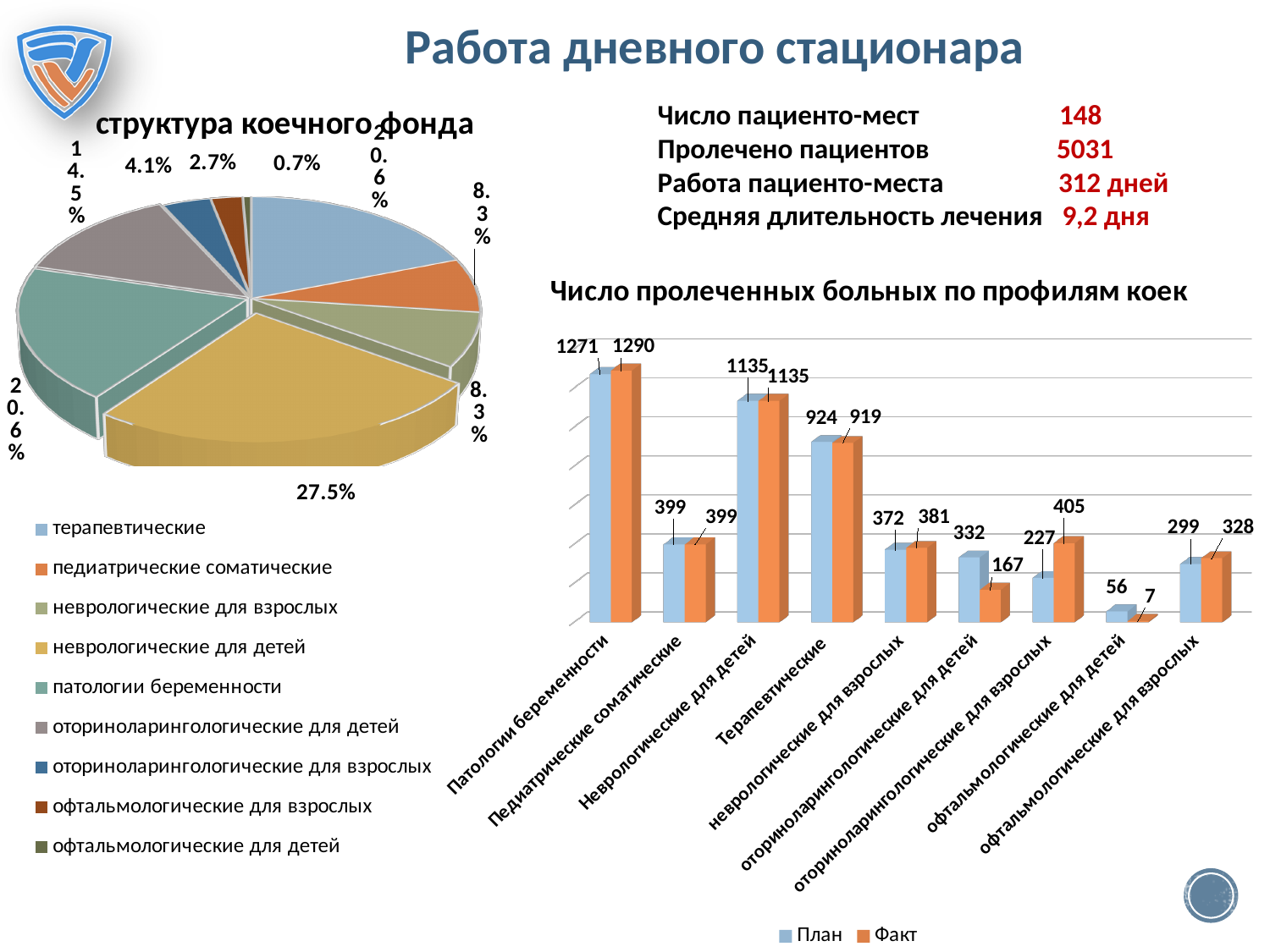
How many categories does the legend of the pie chart 'структура коечного фонда' list? 9 In the pie chart 'структура коечного фонда', what share do неврологические для детей have? 27.5% How many series does the legend of the chart 'Число пролеченных больных по профилям коек' list? 2 In the chart 'Число пролеченных больных по профилям коек', which category has the highest План value? Патологии беременности In the chart 'Число пролеченных больных по профилям коек', what is the План value for оториноларингологические для детей? 332 In the chart 'Число пролеченных больных по профилям коек', what is the Факт value for Патологии беременности? 1290 How many categories are shown on the x axis of the chart 'Число пролеченных больных по профилям коек'? 9 What kind of chart is 'Число пролеченных больных по профилям коек'? bar chart In the chart 'Число пролеченных больных по профилям коек', which is larger for Терапевтические: План or Факт? План In the pie chart 'структура коечного фонда', which category has the largest slice? неврологические для детей In the chart 'Число пролеченных больных по профилям коек', which category has the lowest Факт value? офтальмологические для детей In the chart 'Число пролеченных больных по профилям коек', what is the difference between the Факт and План values for оториноларингологические для взрослых? 178